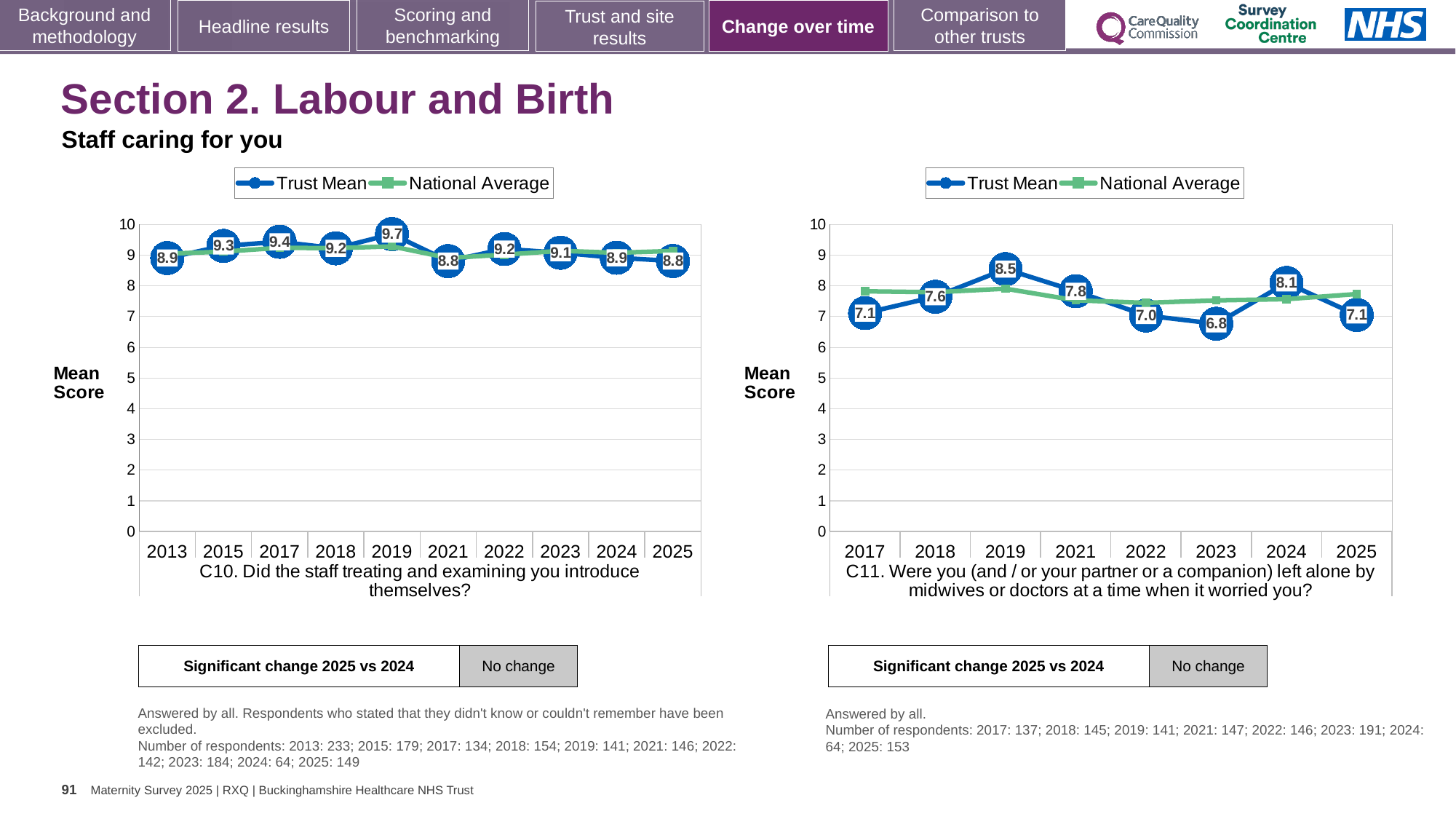
In the C11 chart (right), which year has the lowest Trust Mean? 2023 In the C10 chart (left), what is the Trust Mean for 2019? 9.7 In the C10 chart (left), which year has the highest Trust Mean? 2019 How many series does the legend of the C11 chart (right) list? 2 In the C11 chart (right), which year has the highest Trust Mean? 2019 In the C11 chart (right), what is the difference between the Trust Mean in 2019 and in 2023? 1.7 In the C11 chart (right), what is the Trust Mean for 2023? 6.8 In the C10 chart (left), is the Trust Mean for 2017 greater or less than 9? greater In the C10 chart (left), how many years are plotted on the x axis? 10 What type of chart is the C10 chart (left)? Line chart In the C11 chart (right), is the Trust Mean higher in 2024 or in 2025? 2024 In the C10 chart (left), what is the difference between the Trust Mean in 2019 and in 2025? 0.9